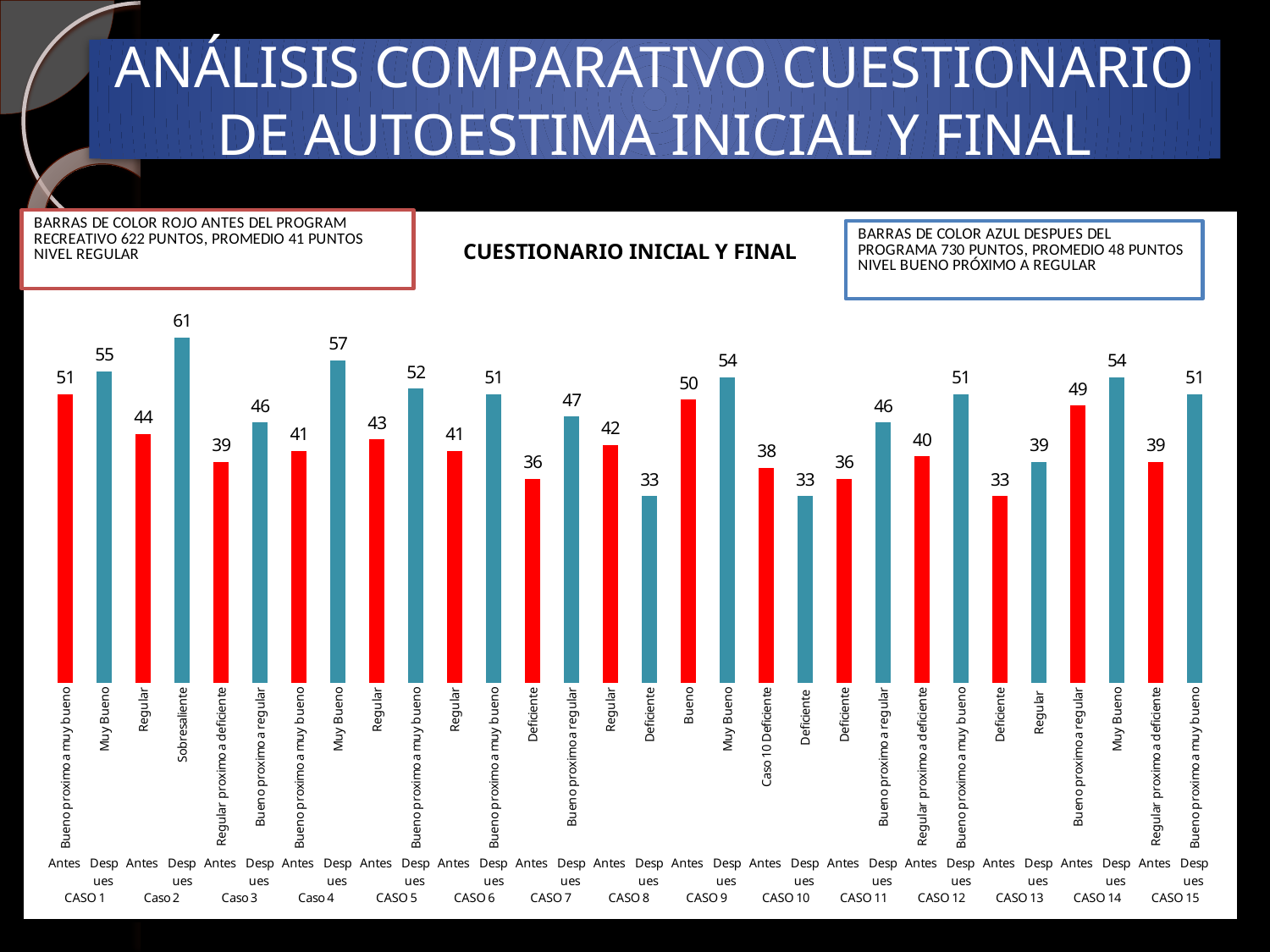
How many cases are shown in the chart? 15 For CASO 8, which is larger: the 'Antes' value or the 'Despues' value? Antes What type of chart is shown on the slide? Bar chart What is the difference between the 'Antes' and 'Despues' values for CASO 10? 5 What is the 'Antes' value for CASO 14? 49 What is the 'Despues' value for CASO 8? 33 For CASO 7, which is larger: the 'Antes' value or the 'Despues' value? Despues What is the 'Despues' value for Caso 2? 61 What is the 'Antes' value for CASO 1? 51 What is the difference between the 'Despues' and 'Antes' values for Caso 4? 16 What is the lowest value shown in the chart? 33 Which case has the highest bar in the chart? Caso 2 (Despues, 61)